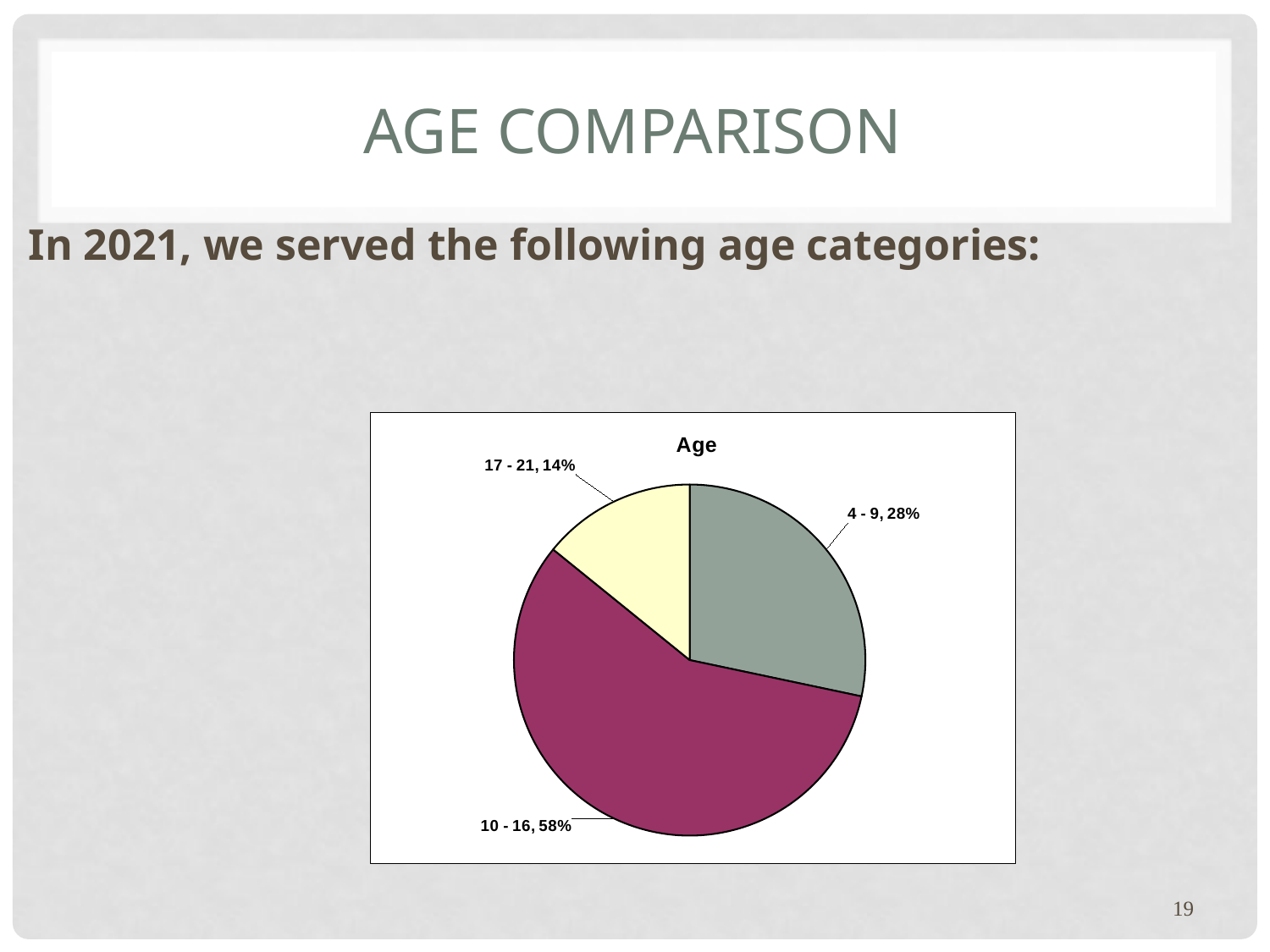
What kind of chart is shown on the slide? pie chart What colour is the slice for the 10 - 16 age category? magenta/purple How many age categories are shown in the pie chart? 3 Which category has a larger share, 4 - 9 or 17 - 21? 4 - 9 What is the difference in percentage points between the 10 - 16 and 4 - 9 categories? 30 What percentage of the pie is the 17 - 21 age category? 14% What is the difference in percentage points between the 4 - 9 and 17 - 21 categories? 14 What is the title of the chart? Age What percentage of the pie is the 10 - 16 age category? 58% What percentage of the pie is the 4 - 9 age category? 28% Which age category has the smallest share of the pie? 17 - 21 Which age category has the largest share of the pie? 10 - 16